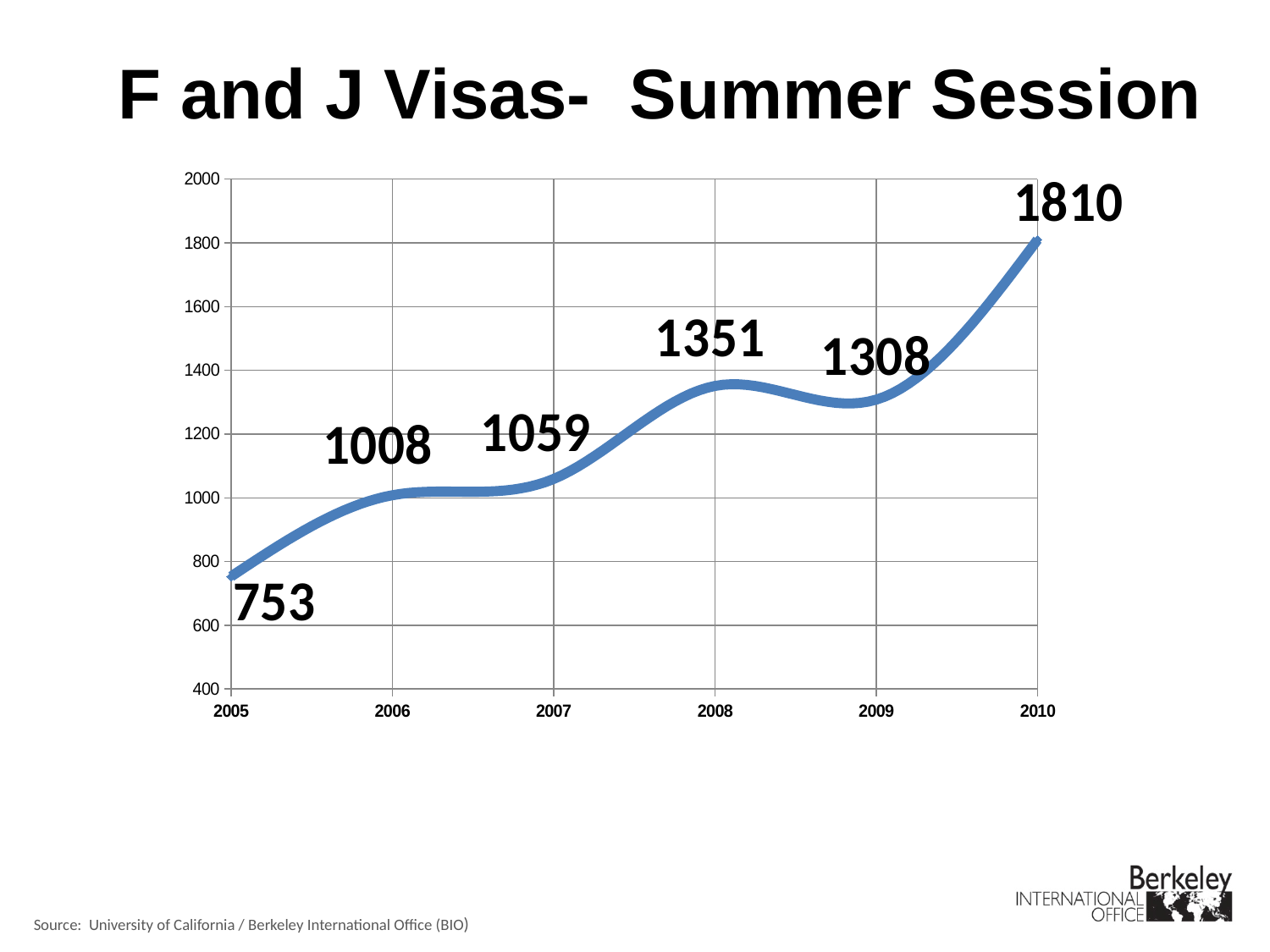
Is the value for 2007 greater or less than 1000? greater What is the value for 2010? 1810 What is the value for 2005? 753 Which year has the lowest value? 2005 What is the value for 2008? 1351 Which is larger, the value for 2008 or the value for 2009? 2008 What is the title of the chart? F and J Visas- Summer Session What kind of chart is shown on the slide? line chart What is the difference between the values for 2006 and 2005? 255 What is the difference between the values for 2010 and 2009? 502 Which year has the highest value? 2010 How many years are plotted on the chart? 6